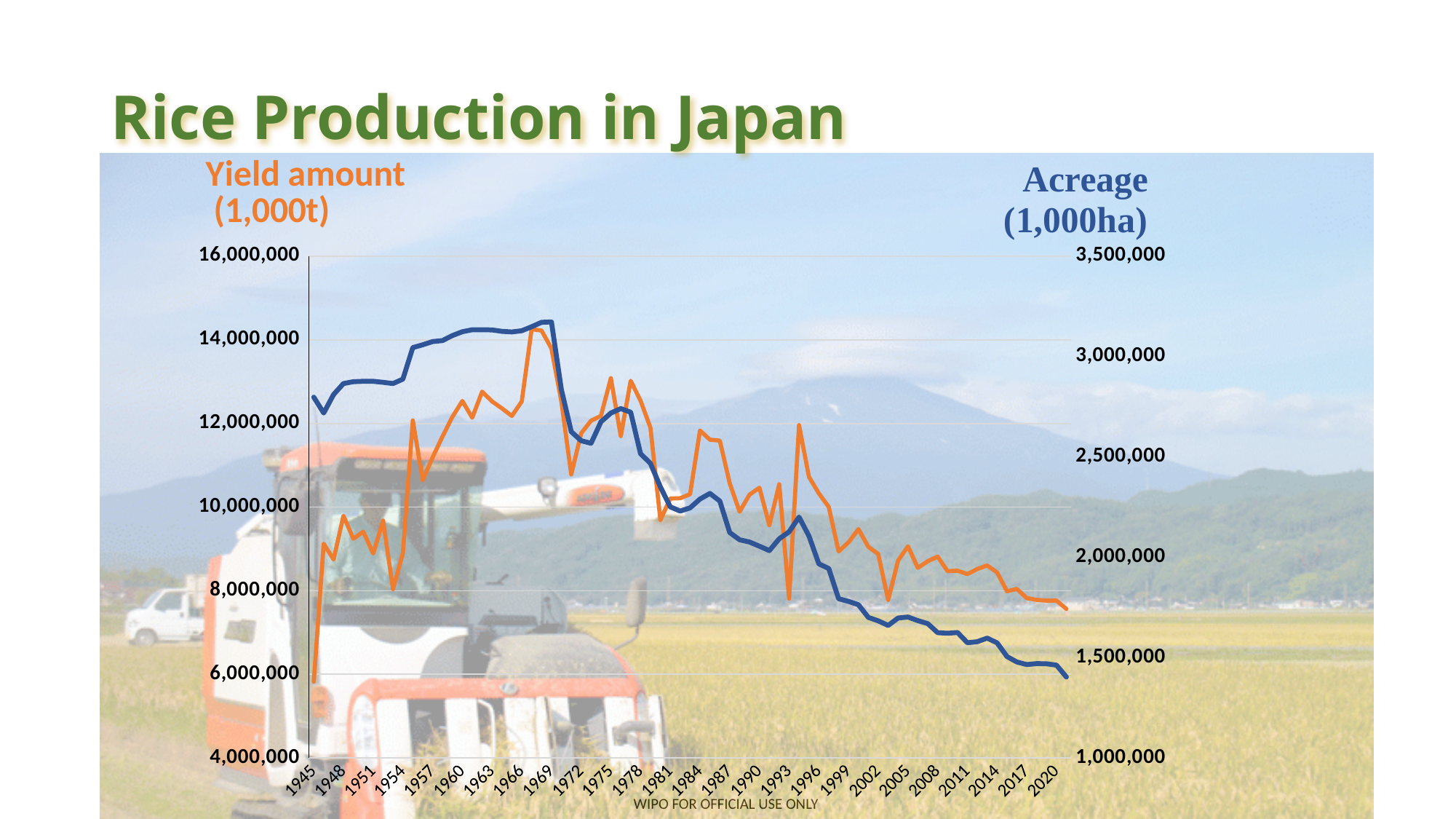
What kind of chart is shown on the slide? line chart How many data series are plotted on the chart? 2 Does the Yield amount line rise or fall from 1945 to 1969? rise Does the Acreage line rise or fall from 1969 to 2020? fall What is the title of the slide containing the chart? Rice Production in Japan Is the Yield amount value for 2020 greater or less than 8,000,000? less Is the Yield amount value for 1969 greater or less than 12,000,000? greater Is the Acreage value for 2020 greater or less than 1,500,000? less Which colour is used for the Acreage line? blue How many year labels are shown on the x axis? 26